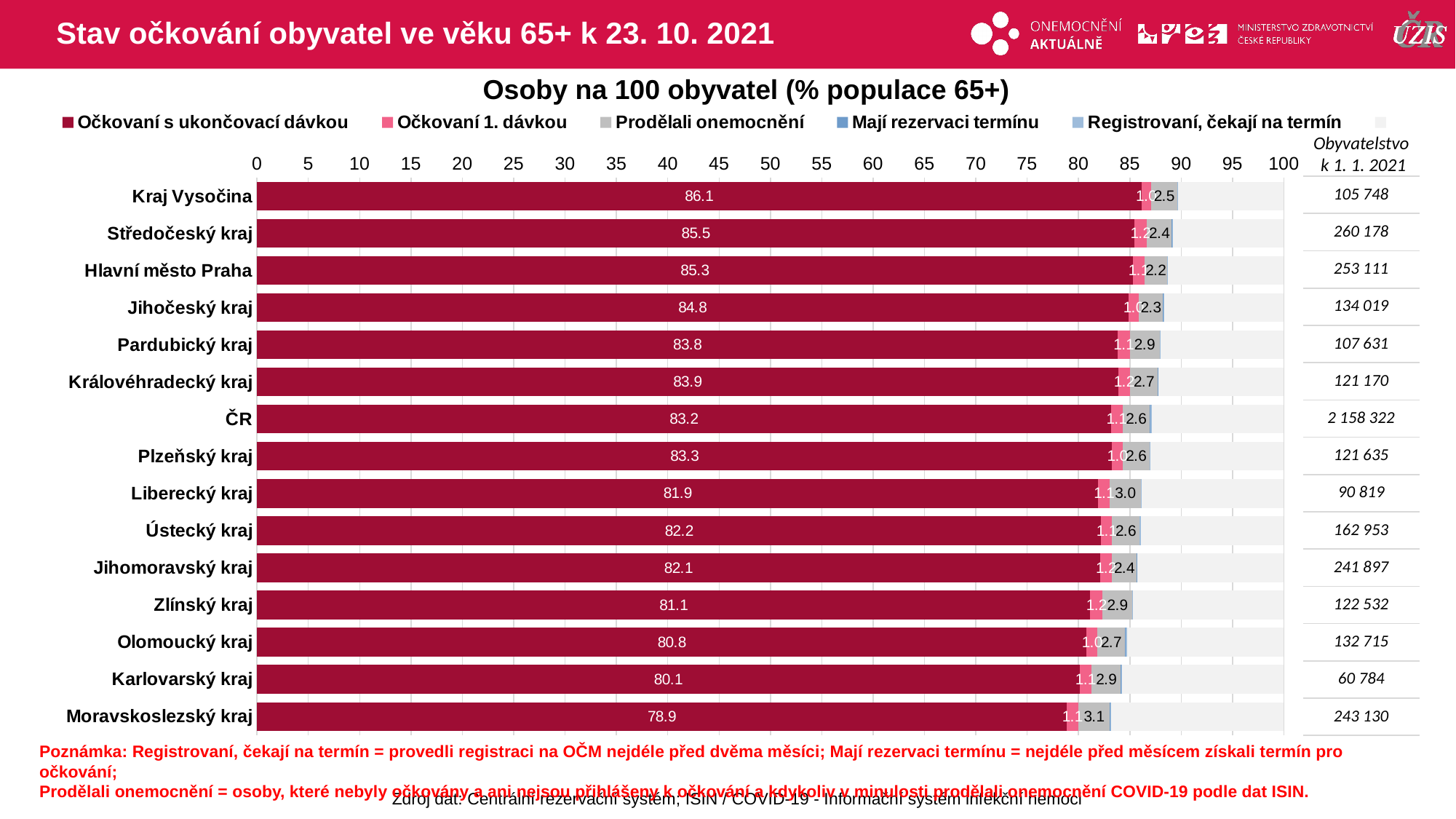
What kind of chart is shown on the slide? Stacked bar chart What is the value of 'Prodělali onemocnění' for Liberecký kraj? 3.0 Which region has the lowest value of 'Očkovaní s ukončovací dávkou'? Moravskoslezský kraj Which region has the highest value of 'Očkovaní s ukončovací dávkou'? Kraj Vysočina What is the difference in 'Prodělali onemocnění' between Moravskoslezský kraj and Kraj Vysočina? 0.6 What is the value of 'Očkovaní s ukončovací dávkou' for Moravskoslezský kraj? 78.9 What is the title of the chart? Osoby na 100 obyvatel (% populace 65+) What is the value of 'Očkovaní s ukončovací dávkou' for Kraj Vysočina? 86.1 Which has a higher value of 'Očkovaní s ukončovací dávkou': Hlavní město Praha or Plzeňský kraj? Hlavní město Praha What is the value of 'Očkovaní s ukončovací dávkou' for ČR? 83.2 What is the difference in 'Očkovaní s ukončovací dávkou' between Kraj Vysočina and Moravskoslezský kraj? 7.2 How many categories (rows) are shown in the chart? 15